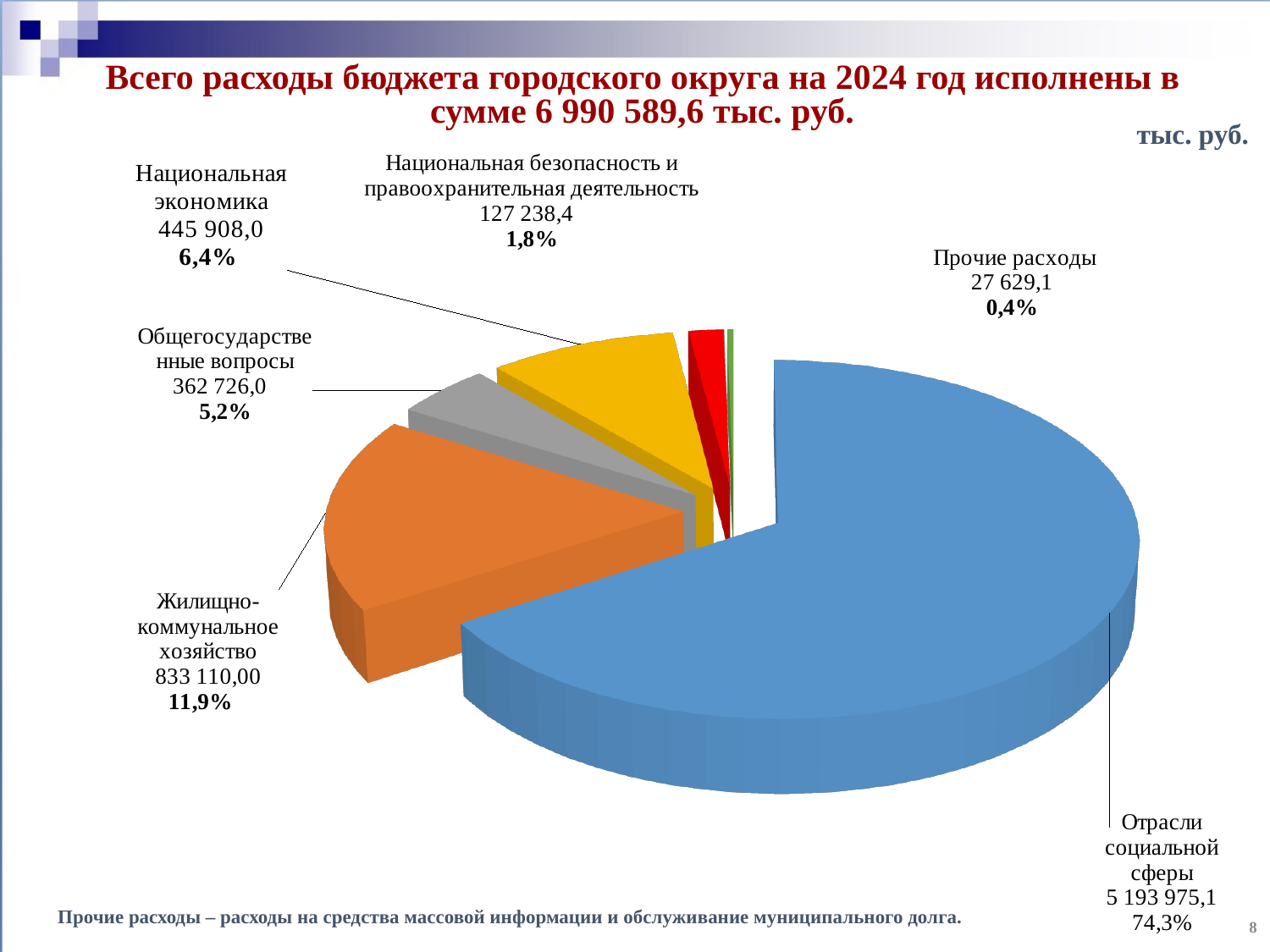
What is the value for Отрасли социальной сферы? 5 193 975,1 Which category has the largest share of the pie? Отрасли социальной сферы Which is larger: Национальная экономика or Общегосударственные вопросы? Национальная экономика How many categories (slices) does the pie chart show? 6 What share of the pie does Прочие расходы represent? 0,4% What type of chart is shown on the slide? Pie chart What share of the pie does Общегосударственные вопросы represent? 5,2% What is the difference in percentage points between the shares of Жилищно-коммунальное хозяйство and Национальная экономика? 5,5% What is the value for Национальная экономика? 445 908,0 What is the value for Национальная безопасность и правоохранительная деятельность? 127 238,4 Which category has the smallest share of the pie? Прочие расходы What share of the pie does Жилищно-коммунальное хозяйство represent? 11,9%